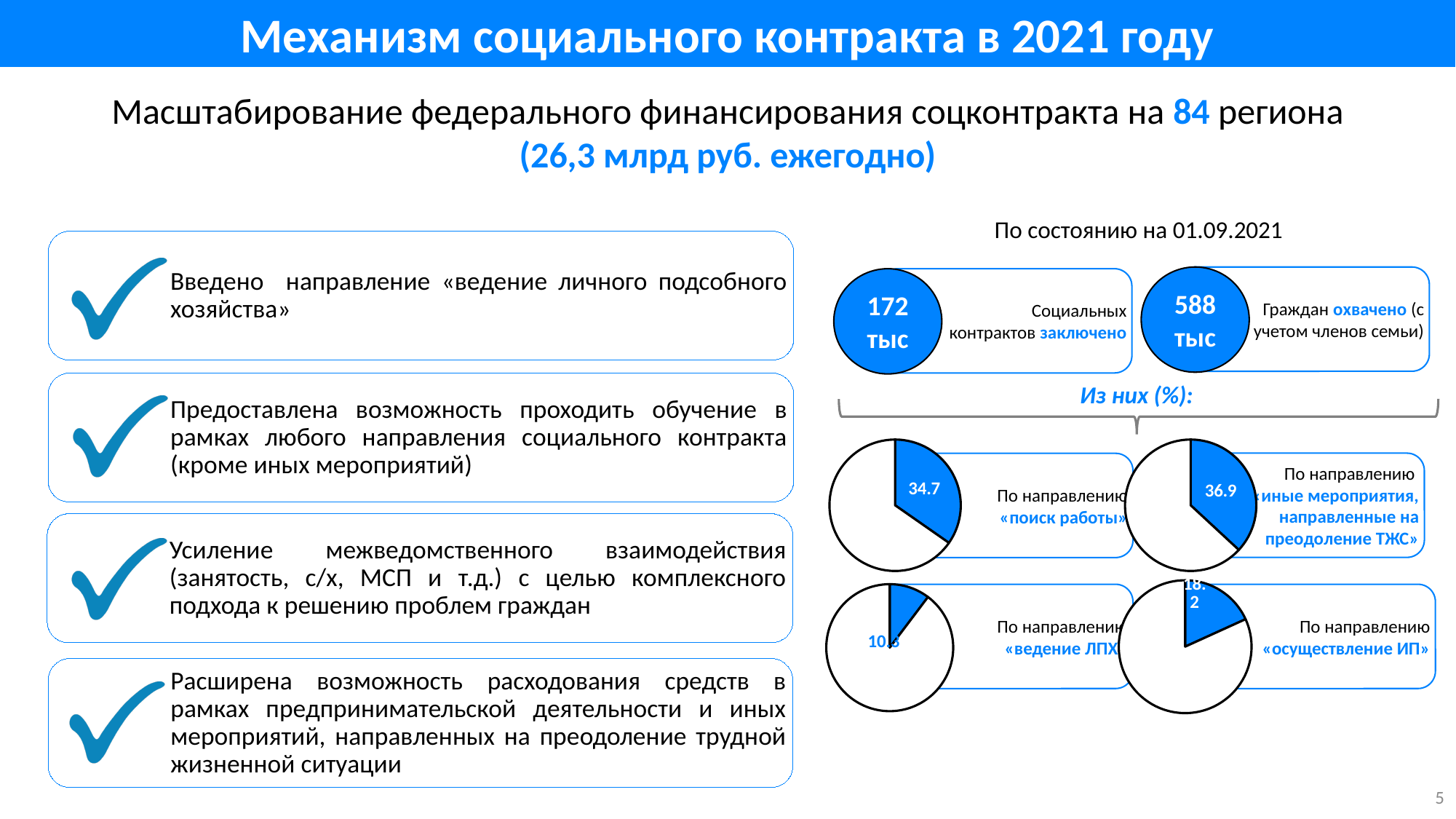
Which of the four directions shown in the pie charts has the largest share? «иные мероприятия, направленные на преодоление ТЖС» How many slices does each pie chart on the slide have? 2 Which of the four directions shown in the pie charts has the smallest share? «ведение ЛПХ» In the pie chart for the direction «поиск работы», what percentage is shown for the highlighted slice? 34.7 How many pie charts are shown on the slide under «Из них (%)»? 4 Which direction has the largest share among the four pie charts: «поиск работы» or «иные мероприятия, направленные на преодоление ТЖС»? «иные мероприятия, направленные на преодоление ТЖС» Is the share for «осуществление ИП» larger or smaller than the share for «иные мероприятия, направленные на преодоление ТЖС»? smaller In the pie chart for the direction «иные мероприятия, направленные на преодоление ТЖС», what percentage is shown for the highlighted slice? 36.9 What is the difference between the share for «иные мероприятия, направленные на преодоление ТЖС» and the share for «поиск работы»? 2.2 Is the share for «поиск работы» larger or smaller than the share for «ведение ЛПХ»? larger What colour is the highlighted slice in each of the pie charts? blue What kind of chart is used to show the share for the direction «поиск работы»? pie chart